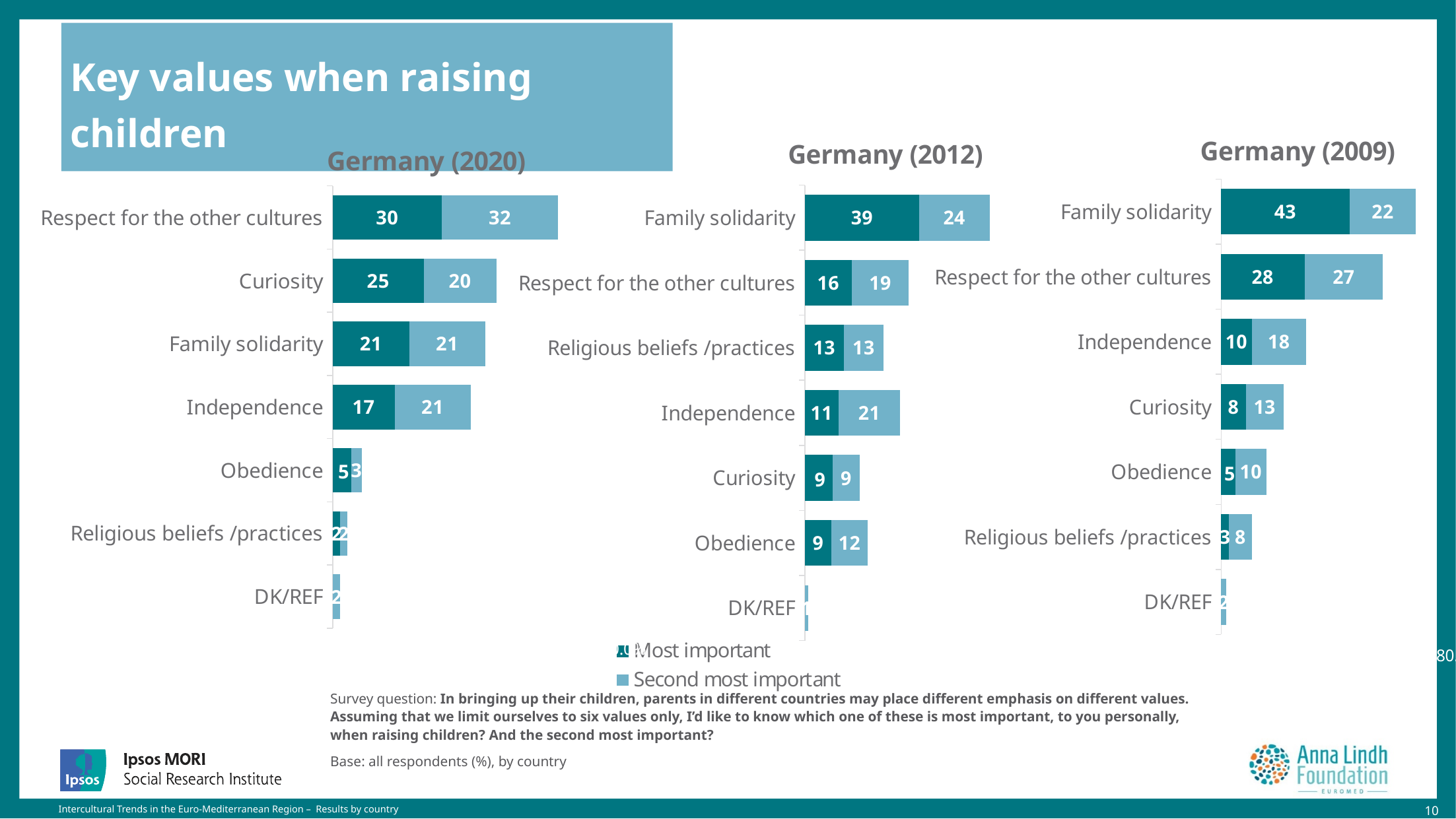
How many series does the legend list? 2 In the Germany (2020) chart, which category has the highest 'Most important' value? Respect for the other cultures In the Germany (2012) chart, what is the difference between the 'Most important' values for Family solidarity and Respect for the other cultures? 23 In the Germany (2009) chart, which category has the lowest 'Most important' value (excluding DK/REF)? Religious beliefs /practices In the Germany (2020) chart, what is the 'Most important' value for Respect for the other cultures? 30 In the Germany (2009) chart, what is the 'Most important' value for Family solidarity? 43 How many categories are shown in the Germany (2012) chart? 7 In the Germany (2012) chart, what is the 'Second most important' value for Independence? 21 In the Germany (2012) chart, what is the total of the stacked bar for Family solidarity? 63 In the Germany (2020) chart, which is larger: the 'Most important' value for Curiosity or for Independence? Curiosity In the Germany (2009) chart, what is the total of the stacked bar for Respect for the other cultures? 55 What kind of chart is the Germany (2020) chart? Stacked bar chart